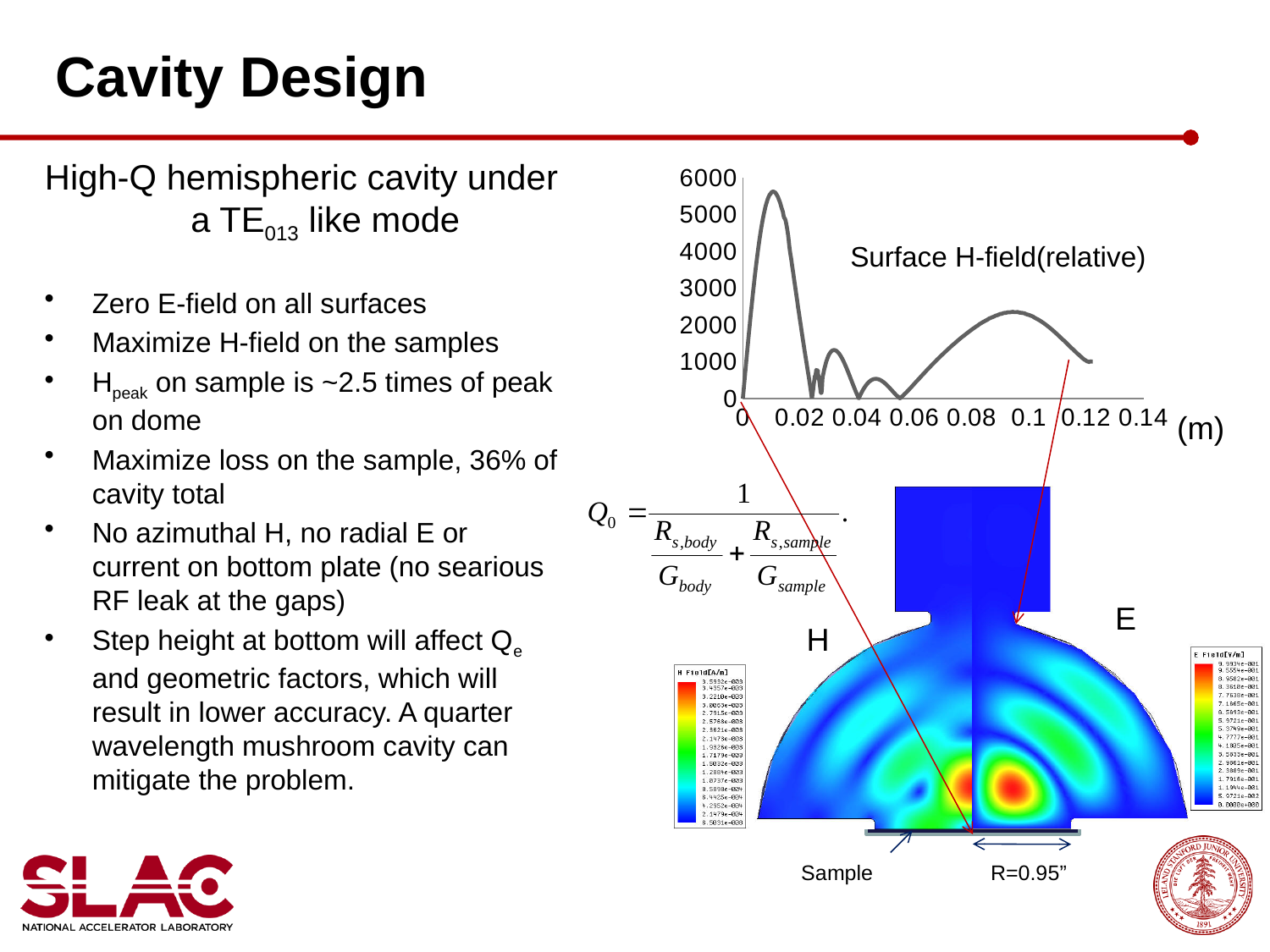
What kind of chart is the 'Surface H-field(relative)' chart on the right of the slide? line chart In the 'Surface H-field(relative)' chart, is the value of the curve at x = 0.1 greater or less than 1000? greater What is the highest value labelled on the y axis of the 'Surface H-field(relative)' chart? 6000 What unit label is shown at the end of the x axis of the 'Surface H-field(relative)' chart? (m) In the 'Surface H-field(relative)' chart, is the value of the curve at x = 0.1 greater or less than 3000? less How many tick labels are shown on the y axis of the 'Surface H-field(relative)' chart? 7 How many tick labels are shown on the x axis of the 'Surface H-field(relative)' chart? 8 What is the title text shown inside the line chart on the right of the slide? Surface H-field(relative) In the 'Surface H-field(relative)' chart, does the curve rise or fall between x = 0.1 and x = 0.12? fall What is the largest value labelled on the x axis of the 'Surface H-field(relative)' chart? 0.14 In the 'Surface H-field(relative)' chart, is the first peak (near x = 0.01) higher or lower than the broad peak near x = 0.1? higher In the 'Surface H-field(relative)' chart, is the peak value of the curve near x = 0.01 greater or less than 5000? greater